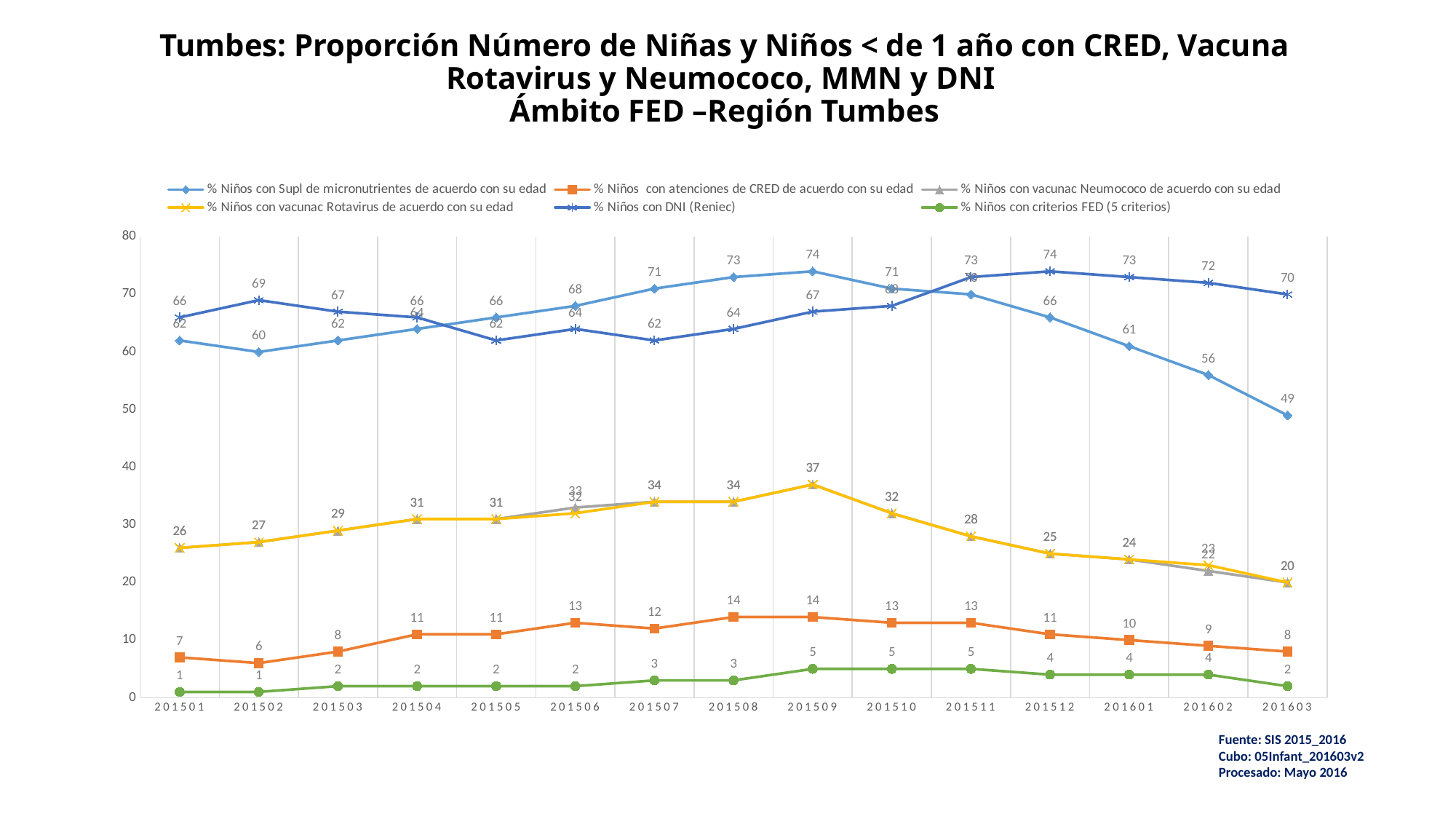
What is the value for '% Niños con criterios FED (5 criterios)' at 201603? 2 How many periods are shown along the x axis? 15 What is the value for '% Niños con vacunac Rotavirus de acuerdo con su edad' at 201509? 37 What is the value for '% Niños con DNI (Reniec)' at 201512? 74 What kind of chart is shown on the slide? line chart Does '% Niños con Supl de micronutrientes de acuerdo con su edad' rise or fall from 201509 to 201603? fall In which period does '% Niños con Supl de micronutrientes de acuerdo con su edad' reach its highest value? 201509 At 201603, which is larger: '% Niños con DNI (Reniec)' or '% Niños con Supl de micronutrientes de acuerdo con su edad'? % Niños con DNI (Reniec) In which period does '% Niños con Supl de micronutrientes de acuerdo con su edad' reach its lowest value? 201603 What is the difference between the '% Niños con Supl de micronutrientes de acuerdo con su edad' values at 201509 and 201603? 25 What is the value for '% Niños con atenciones de CRED de acuerdo con su edad' at 201509? 14 How many series does the legend list? 6